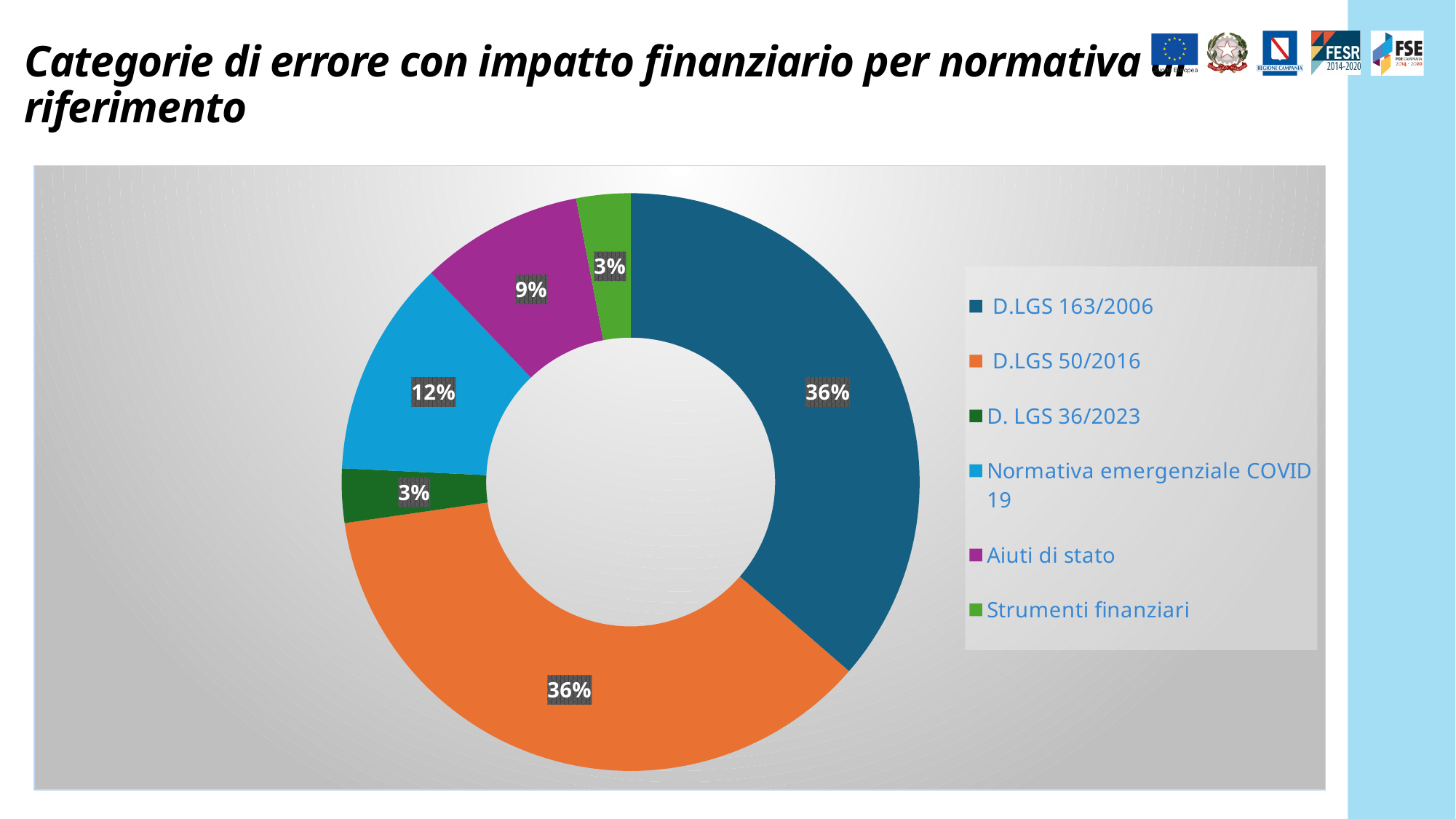
What percentage is shown for Normativa emergenziale COVID 19? 12% What percentage is shown for D. LGS 36/2023? 3% Which is larger, the share for Normativa emergenziale COVID 19 or the share for Aiuti di stato? Normativa emergenziale COVID 19 What kind of chart is shown on the slide? doughnut chart What percentage is shown for Aiuti di stato? 9% How many categories does the chart show? 6 What share of the chart does D.LGS 163/2006 account for? 36% What percentage is shown for Strumenti finanziari? 3% What is the difference in percentage points between D.LGS 163/2006 and Aiuti di stato? 27 What is the difference in percentage points between Normativa emergenziale COVID 19 and Strumenti finanziari? 9 What colour is the slice for D.LGS 50/2016? orange What percentage is shown for D.LGS 50/2016? 36%